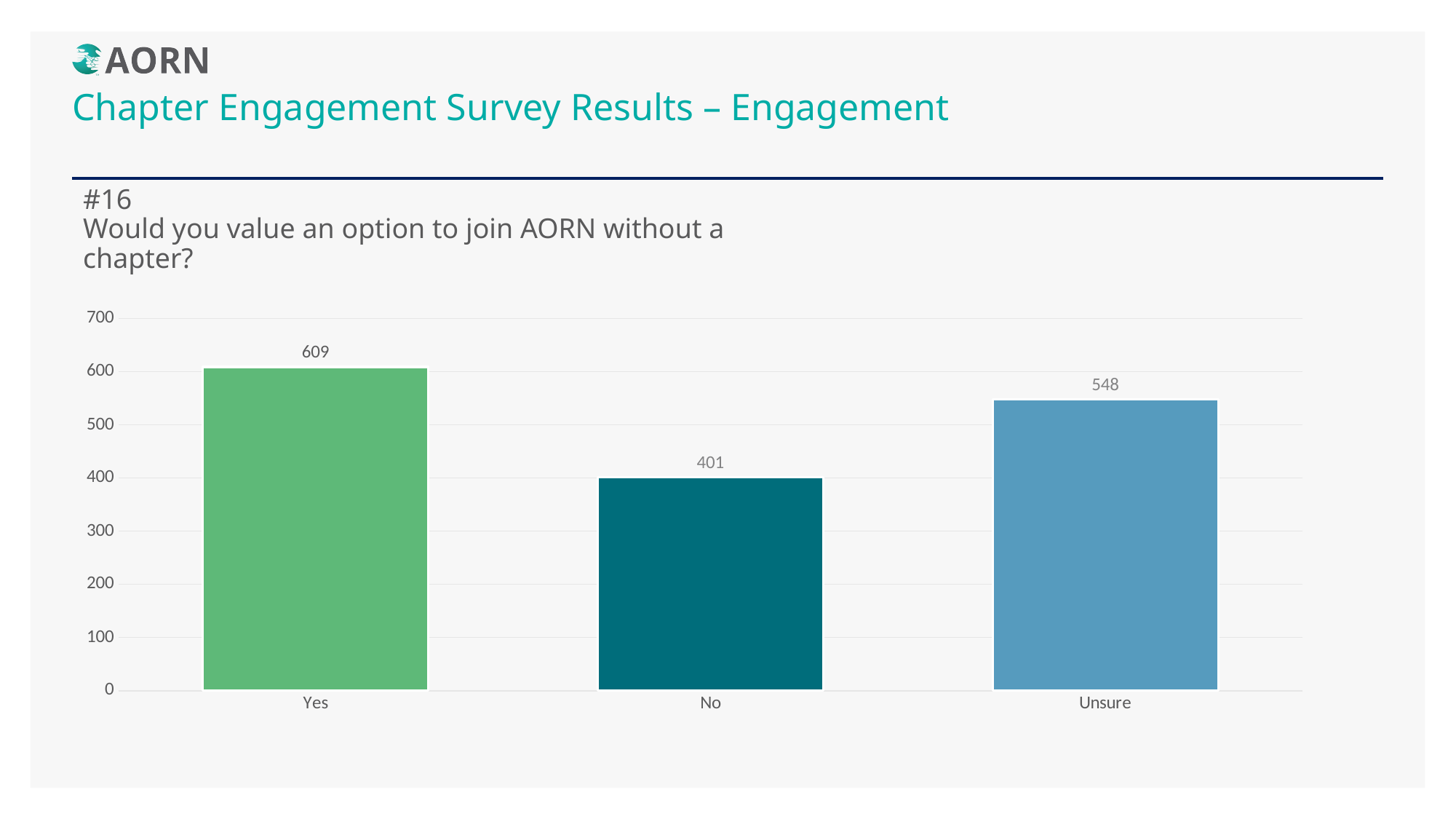
Which category has the highest value? Yes How many categories are shown on the x axis? 3 What is the value for Yes? 609 What is the difference between the values for Yes and No? 208 Which category has the lowest value? No What is the value for No? 401 Is the value for Unsure greater or less than 500? greater What is the difference between the values for Unsure and No? 147 What survey question does the chart show results for? Would you value an option to join AORN without a chapter? Which is larger, the value for Unsure or the value for No? Unsure What kind of chart is shown on the slide? bar chart What is the value for Unsure? 548